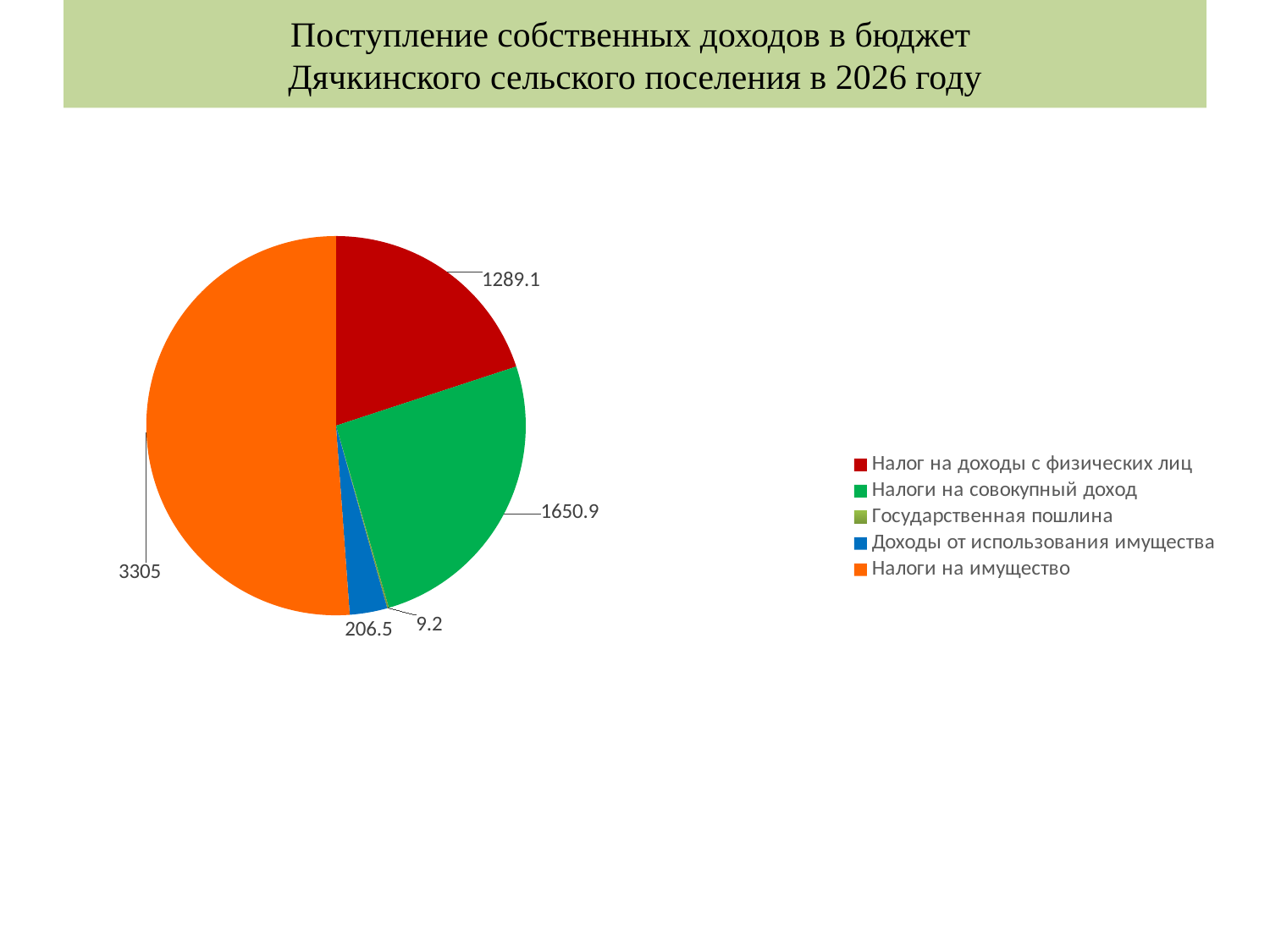
Which category has the largest slice of the pie? Налоги на имущество What is the value for Налоги на совокупный доход? 1650.9 What colour is the slice for Доходы от использования имущества? Blue Which is larger: Налоги на совокупный доход or Налог на доходы с физических лиц? Налоги на совокупный доход What is the value for Налог на доходы с физических лиц? 1289.1 What is the value for Государственная пошлина? 9.2 What type of chart is shown on the slide? Pie chart How many categories does the legend list? 5 What is the difference between the values for Налоги на имущество and Налоги на совокупный доход? 1654.1 What is the value for Налоги на имущество? 3305 What is the value for Доходы от использования имущества? 206.5 Which category has the smallest slice of the pie? Государственная пошлина